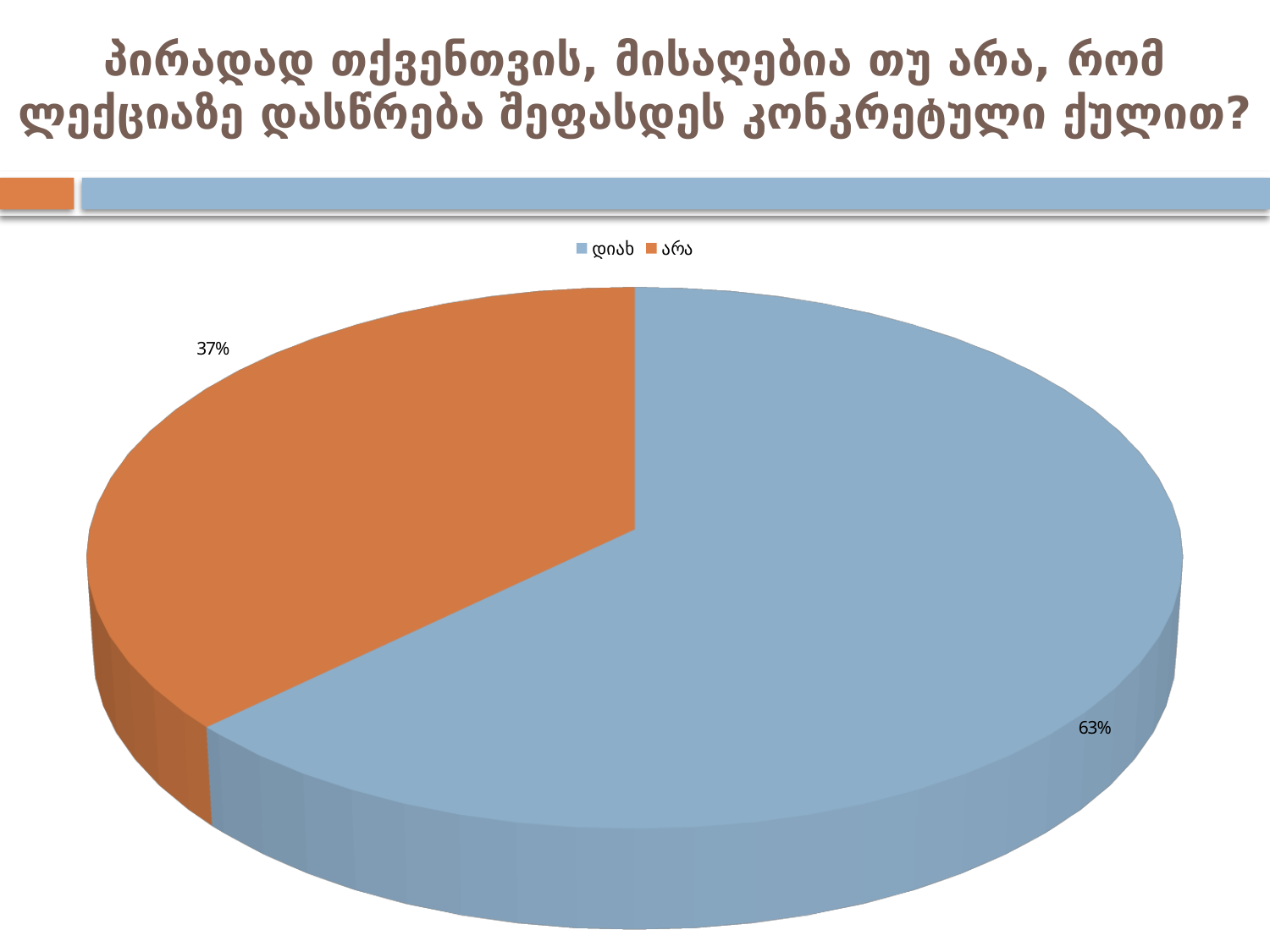
How many slices does the pie chart have? 2 What colour is the არა slice? orange How many entries does the legend list? 2 Which slice is the smallest in the pie chart? არა What share of the pie does the დიახ slice represent? 63% What is the total of the two slice percentages shown on the pie chart? 100% Which slice is the largest in the pie chart? დიახ Which is larger, the დიახ slice or the არა slice? დიახ What kind of chart is shown on the slide? pie chart What is the difference in percentage points between the დიახ and არა slices? 26 What colour is the დიახ slice? blue What share of the pie does the არა slice represent? 37%